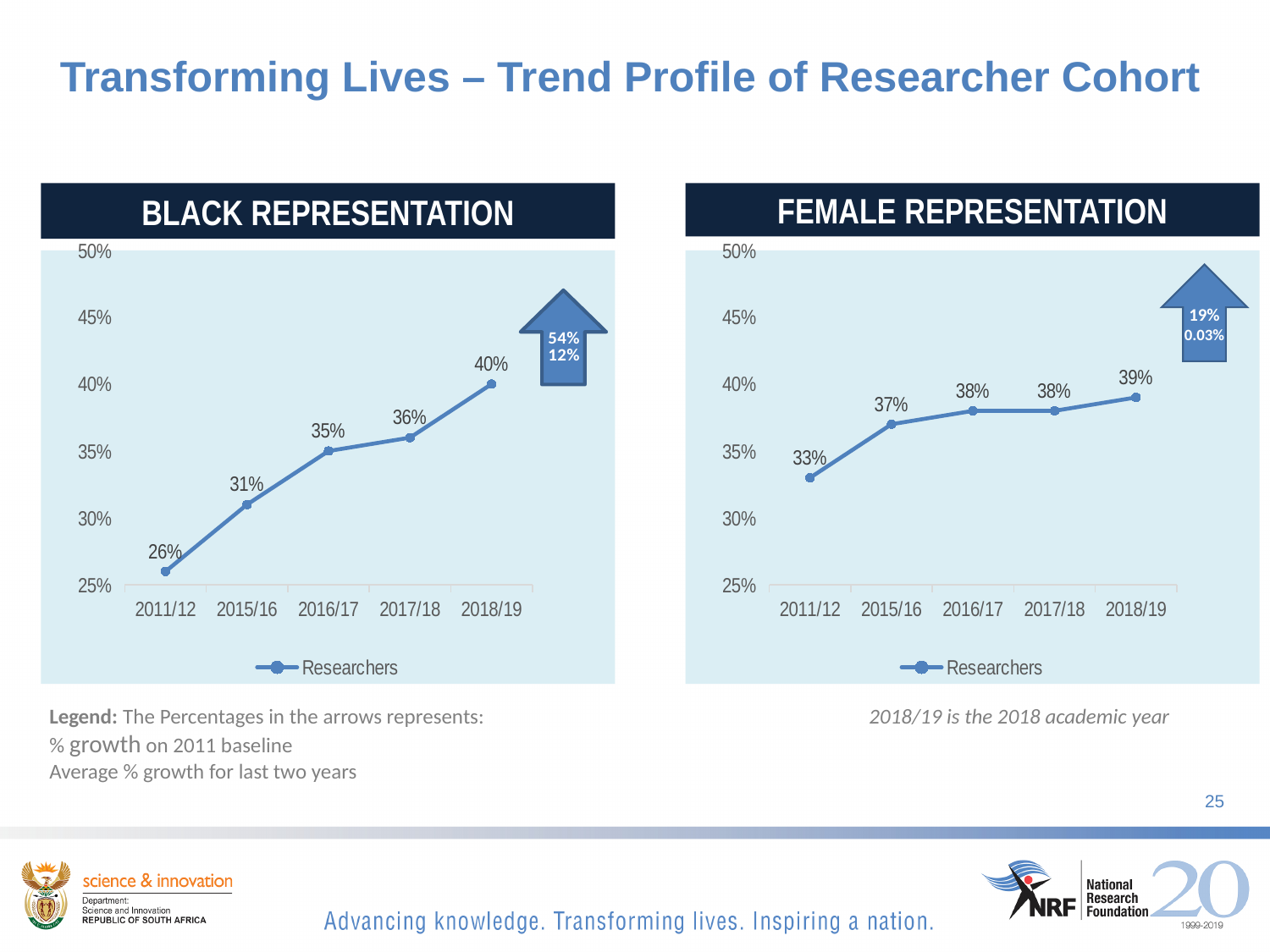
In the FEMALE REPRESENTATION chart, which year has the highest value? 2018/19 In the FEMALE REPRESENTATION chart, what is the value for 2018/19? 39% In the FEMALE REPRESENTATION chart, what is the value for 2015/16? 37% In the BLACK REPRESENTATION chart, which year has the lowest value? 2011/12 Which is larger: the 2016/17 value in the BLACK REPRESENTATION chart or the 2016/17 value in the FEMALE REPRESENTATION chart? FEMALE REPRESENTATION In the BLACK REPRESENTATION chart, do the values rise or fall from 2011/12 to 2018/19? Rise In the BLACK REPRESENTATION chart, what is the value for 2018/19? 40% In the BLACK REPRESENTATION chart, what is the value for 2011/12? 26% In the FEMALE REPRESENTATION chart, what is the difference between the 2018/19 and 2011/12 values? 6% In the BLACK REPRESENTATION chart, what is the difference between the 2018/19 and 2011/12 values? 14% What kind of chart is the FEMALE REPRESENTATION chart? Line chart How many data points are plotted in the BLACK REPRESENTATION chart? 5